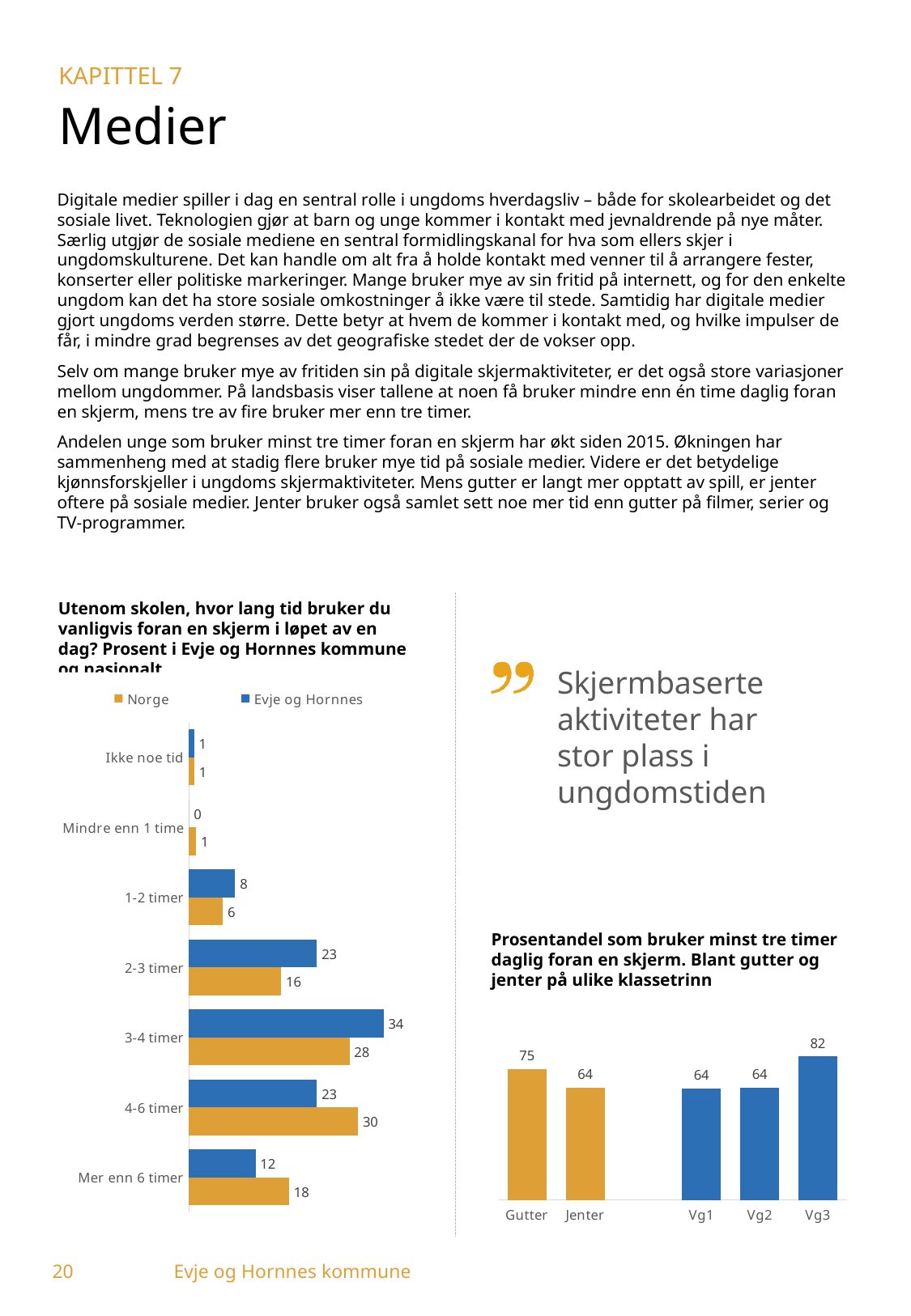
In the left chart (screen time per day), what is the value for Norge in the '4-6 timer' category? 30 What type of chart is the right chart (share using at least three hours daily)? Bar chart In the right chart (share using at least three hours daily), what is the difference between Vg3 and Vg2? 18 In the right chart (share using at least three hours daily), which category has the highest value? Vg3 In the right chart (share using at least three hours daily), what is the value for Gutter? 75 In the left chart (screen time per day), what is the difference between Evje og Hornnes and Norge in the '2-3 timer' category? 7 In the left chart (screen time per day), what is the value for Evje og Hornnes in the 'Mindre enn 1 time' category? 0 In the left chart (screen time per day), which is larger in the 'Mer enn 6 timer' category: Norge or Evje og Hornnes? Norge In the left chart (screen time per day), how many series does the legend list? 2 In the left chart (screen time per day), how many categories are shown? 7 In the left chart (screen time per day), what is the value for Evje og Hornnes in the '3-4 timer' category? 34 In the left chart (screen time per day), which category has the highest value for Evje og Hornnes? 3-4 timer